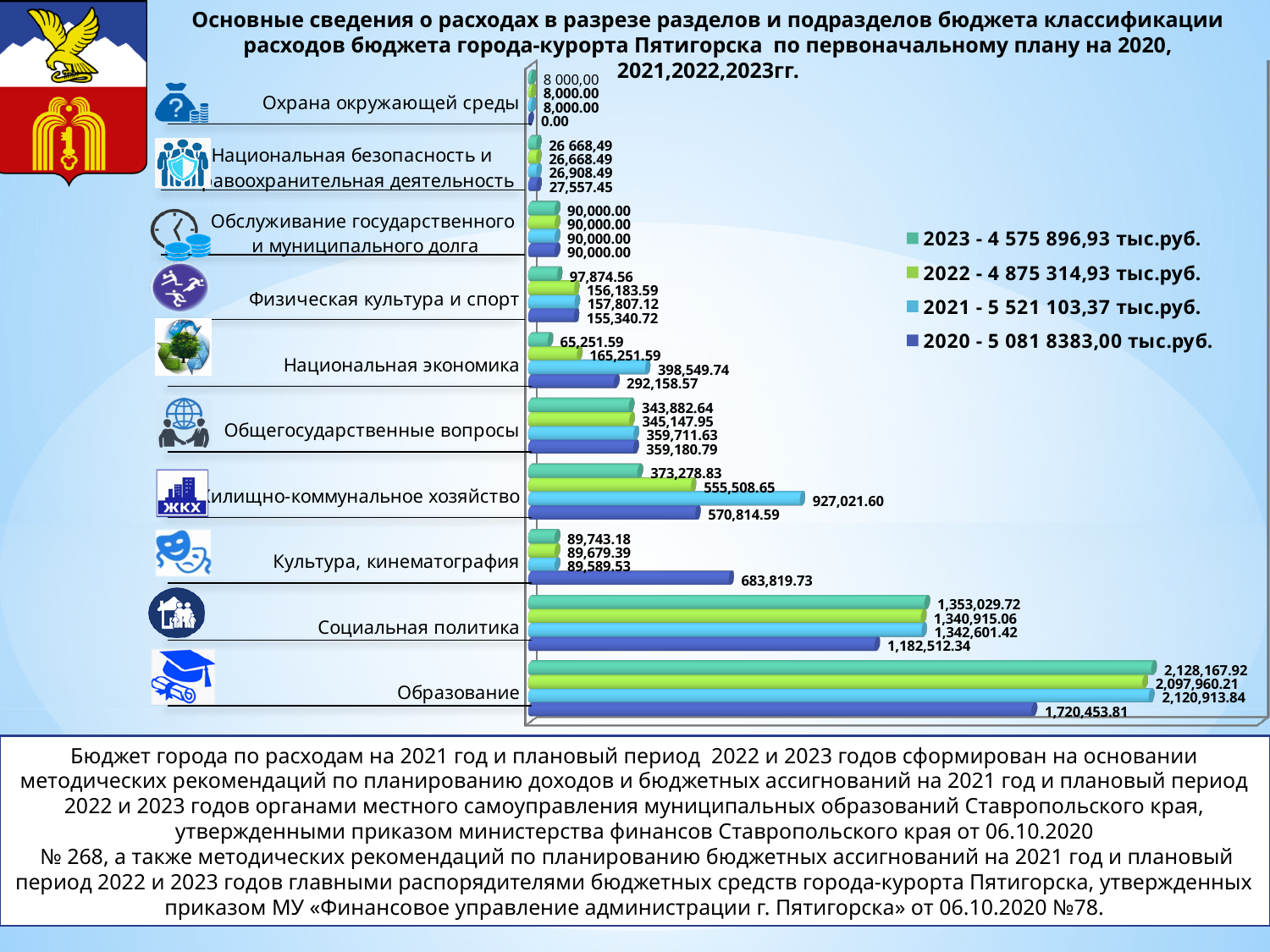
What is the difference between the 2023 and 2020 values for Образование? 407,714.11 Which category has the lowest 2020 value? Охрана окружающей среды Which category has the highest 2023 value? Образование What is the 2021 value for Жилищно-коммунальное хозяйство? 927,021.60 What is the 2023 value for Физическая культура и спорт? 97,874.56 According to the legend, what is the total for 2021? 5 521 103,37 тыс.руб. What is the 2021 value for Национальная экономика? 398,549.74 How many expenditure categories are plotted on the chart? 10 For Социальная политика, which year has the larger value, 2023 or 2022? 2023 What kind of chart is shown on the slide? Bar chart How many series does the chart legend list? 4 What is the 2020 value for Культура, кинематография? 683,819.73